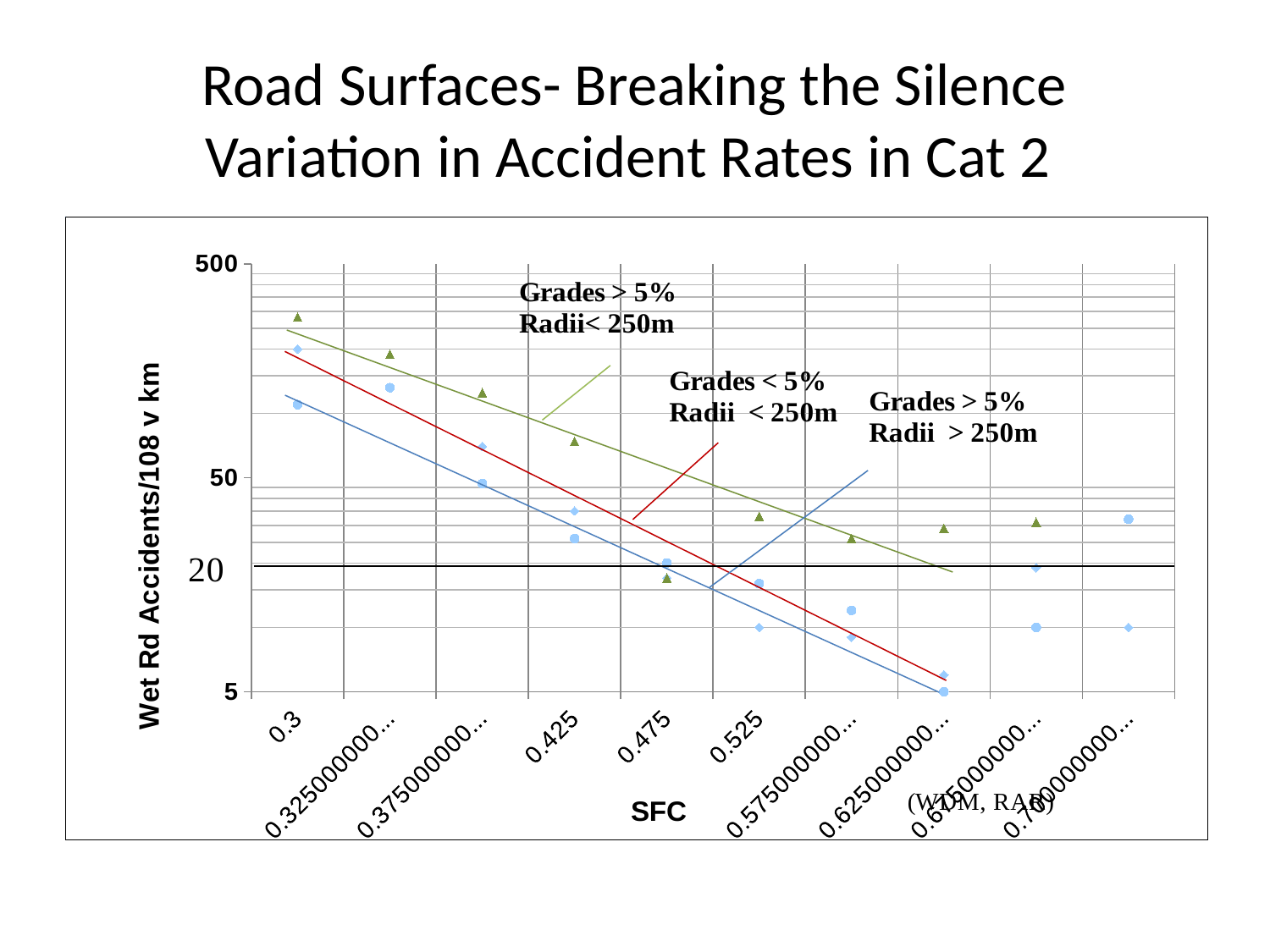
Is the blue circle value at SFC 0.3 greater or less than 50? greater Is the blue circle value at SFC 0.7 greater or less than 20? greater What is the title of the y axis? Wet Rd Accidents/108 v km Is the green triangle value at SFC 0.525 greater or less than 20? greater As SFC increases along the x axis, do the plotted accident rates generally rise or fall? fall What value does the horizontal reference line drawn across the chart mark on the y axis? 20 What kind of chart is shown on the slide? scatter chart At SFC 0.3, which of the three plotted series has the highest value? green triangles (Grades > 5%, Radii < 250m) At SFC 0.3, which is larger: the green triangle value or the blue circle value? green triangle